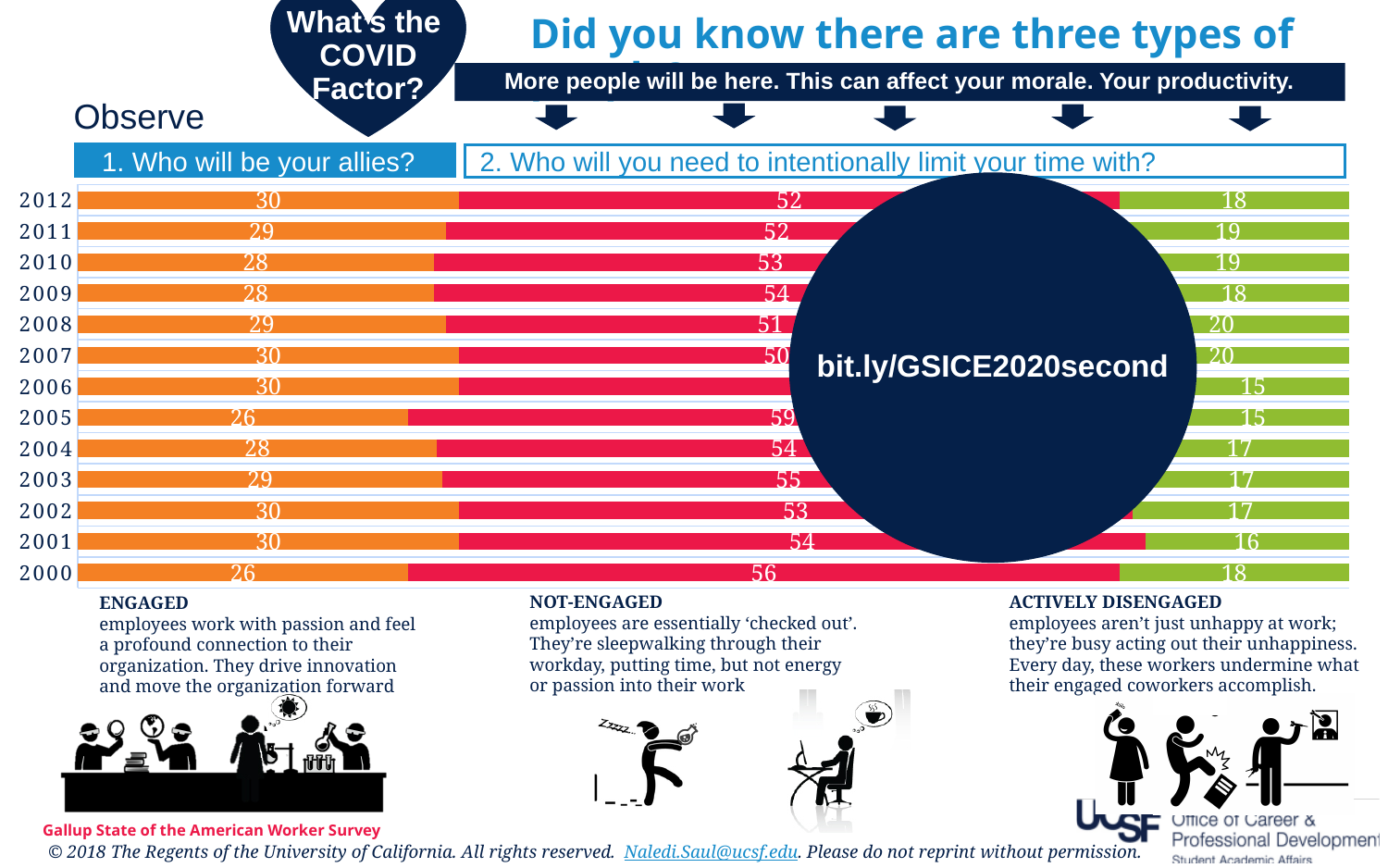
What kind of chart is shown on the slide? stacked bar chart What is the value of the orange (Engaged) segment for 2012? 30 What is the total of the three segments for the 2012 bar? 100 What is the value of the red (Not-Engaged) segment for 2000? 56 Which year has the larger orange (Engaged) value, 2000 or 2012? 2012 What is the value of the red (Not-Engaged) segment for 2005? 59 Which year has the highest red (Not-Engaged) value? 2005 How many years are plotted on the chart? 13 What survey is cited as the source of the chart data? Gallup State of the American Worker Survey What is the difference between the red and orange segment values for 2012? 22 How many segments (series) make up each bar in the chart? 3 What is the value of the green (Actively Disengaged) segment for 2008? 20